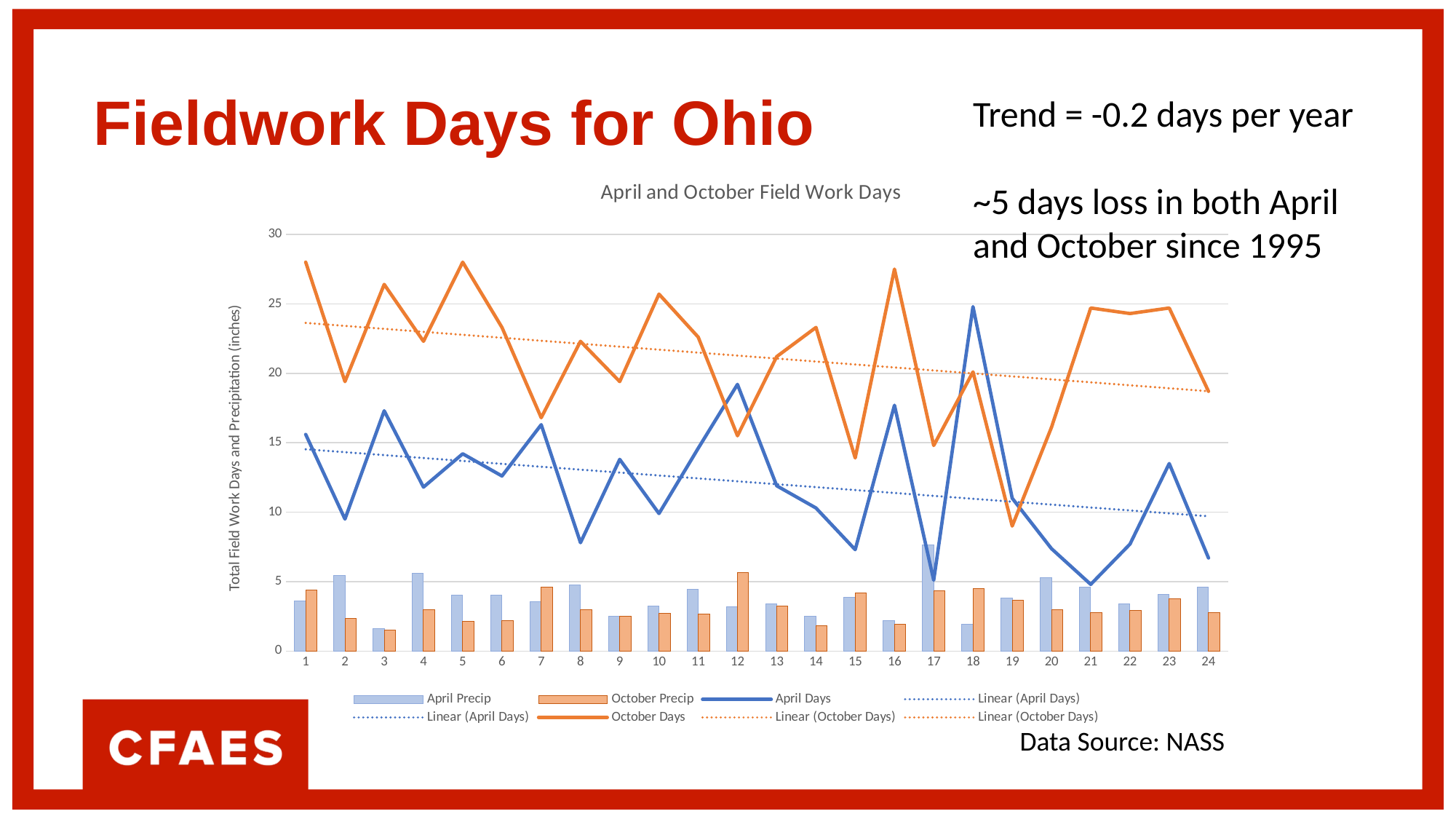
At which x-axis point does the April Days line reach its highest value? 18 Does the dotted Linear (April Days) trendline rise or fall from left to right? Fall Is the April Days value at point 18 greater or less than 20? greater How many entries does the chart's legend list? 8 Is the October Days value at point 1 greater or less than 25? greater Is the October Days value at point 7 greater or less than 20? less What kind of chart is shown on the slide? A combination bar and line chart What is the label on the vertical axis of the chart? Total Field Work Days and Precipitation (inches) At which x-axis point does the October Days line reach its lowest value? 19 What is the title of the chart? April and October Field Work Days How many points are plotted along the x axis of the chart? 24